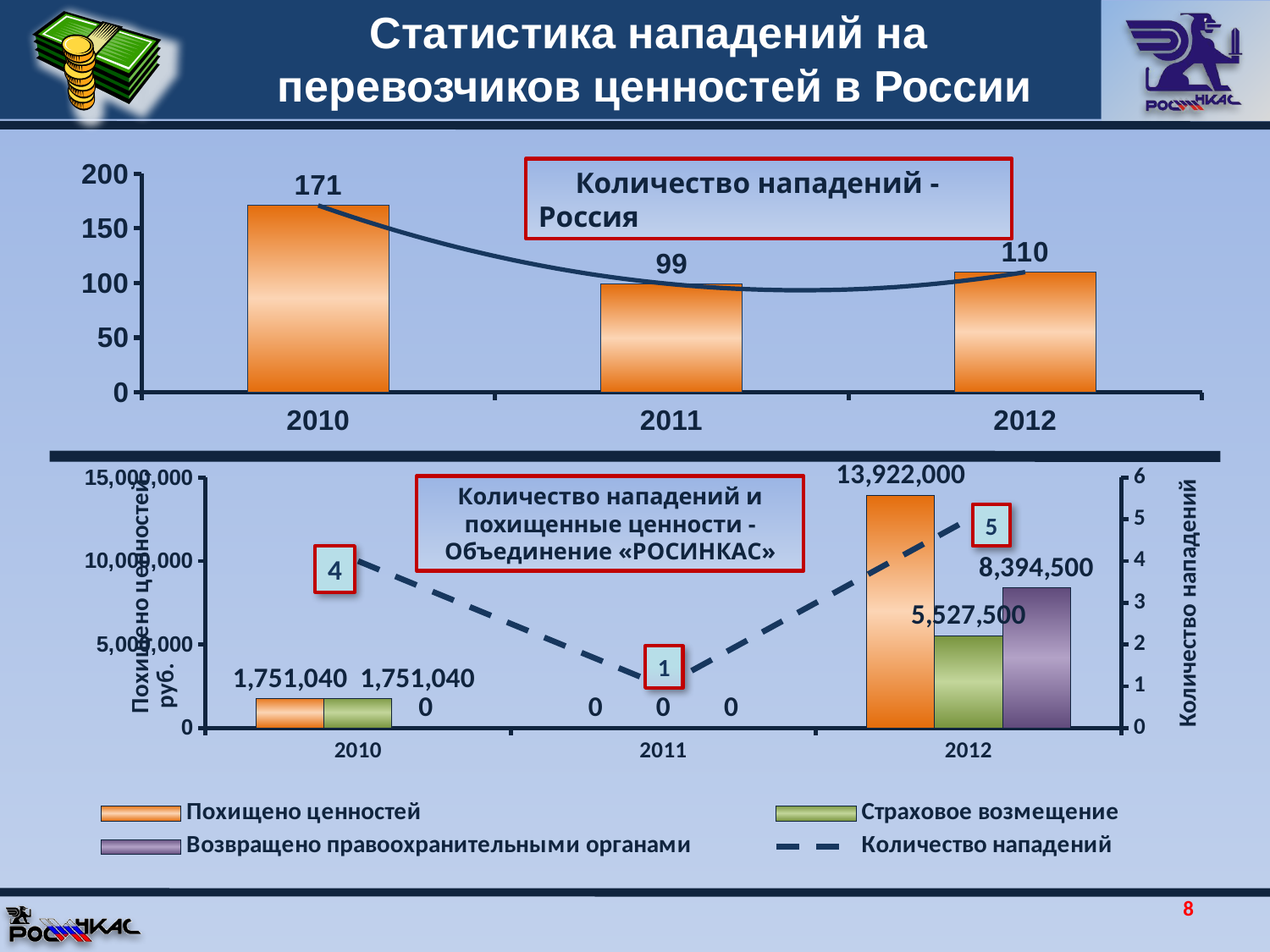
In the bottom chart 'Количество нападений и похищенные ценности - Объединение «РОСИНКАС»', what is the value of 'Возвращено правоохранительными органами' for 2012? 8,394,500 In the top chart 'Количество нападений - Россия', how many years are shown on the x axis? 3 In the top chart 'Количество нападений - Россия', what is the value for 2011? 99 In the bottom chart 'Количество нападений и похищенные ценности - Объединение «РОСИНКАС»', what is the value of 'Похищено ценностей' for 2012? 13,922,000 In the bottom chart 'Количество нападений и похищенные ценности - Объединение «РОСИНКАС»', how many series does the legend list? 4 In the bottom chart 'Количество нападений и похищенные ценности - Объединение «РОСИНКАС»', what is the value of 'Количество нападений' for 2011? 1 In the bottom chart 'Количество нападений и похищенные ценности - Объединение «РОСИНКАС»', what is the difference between 'Похищено ценностей' and 'Страховое возмещение' for 2012? 8,394,500 In the top chart 'Количество нападений - Россия', which year has the lowest value? 2011 In the top chart 'Количество нападений - Россия', what is the difference between the values for 2010 and 2012? 61 In the bottom chart 'Количество нападений и похищенные ценности - Объединение «РОСИНКАС»', which is larger for 2012: 'Страховое возмещение' or 'Возвращено правоохранительными органами'? Возвращено правоохранительными органами In the top chart 'Количество нападений - Россия', which year has the highest value? 2010 In the top chart 'Количество нападений - Россия', what is the value for 2010? 171